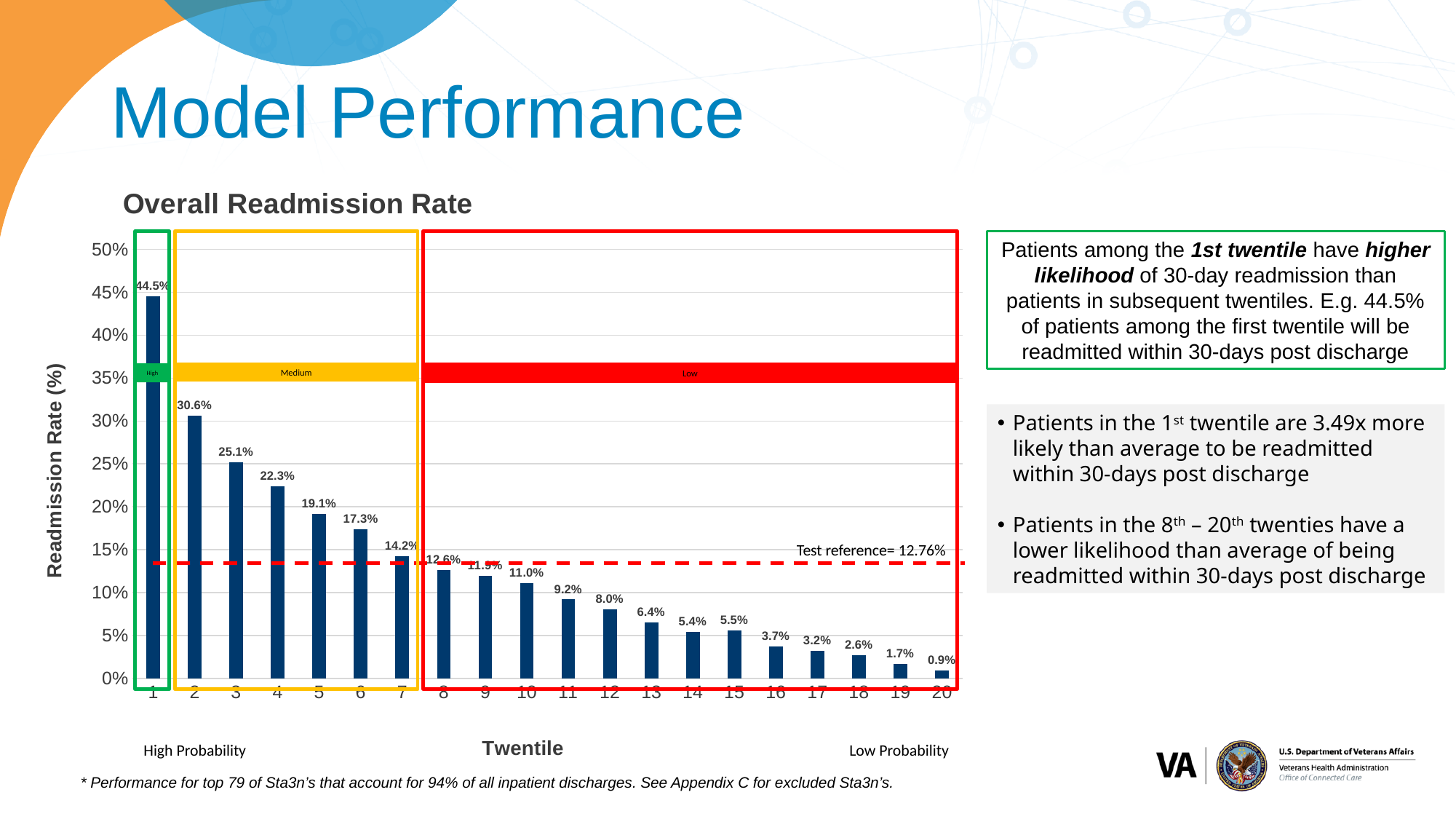
Which twentile has the lowest readmission rate? 20 How many twentiles are plotted on the x axis? 20 Which has a higher readmission rate, twentile 14 or twentile 15? Twentile 15 What is the difference in readmission rate between twentile 1 and twentile 2? 13.9% What is the readmission rate for twentile 12? 8.0% Is the readmission rate for twentile 7 greater or less than 10%? greater Which twentile has the highest readmission rate? 1 Do readmission rates rise or fall as the twentile number increases from 1 to 20? Fall What value is the dashed test reference line set at? 12.76% What is the readmission rate for twentile 4? 22.3% What type of chart is used to show the overall readmission rate? Bar chart What is the readmission rate for twentile 1? 44.5%